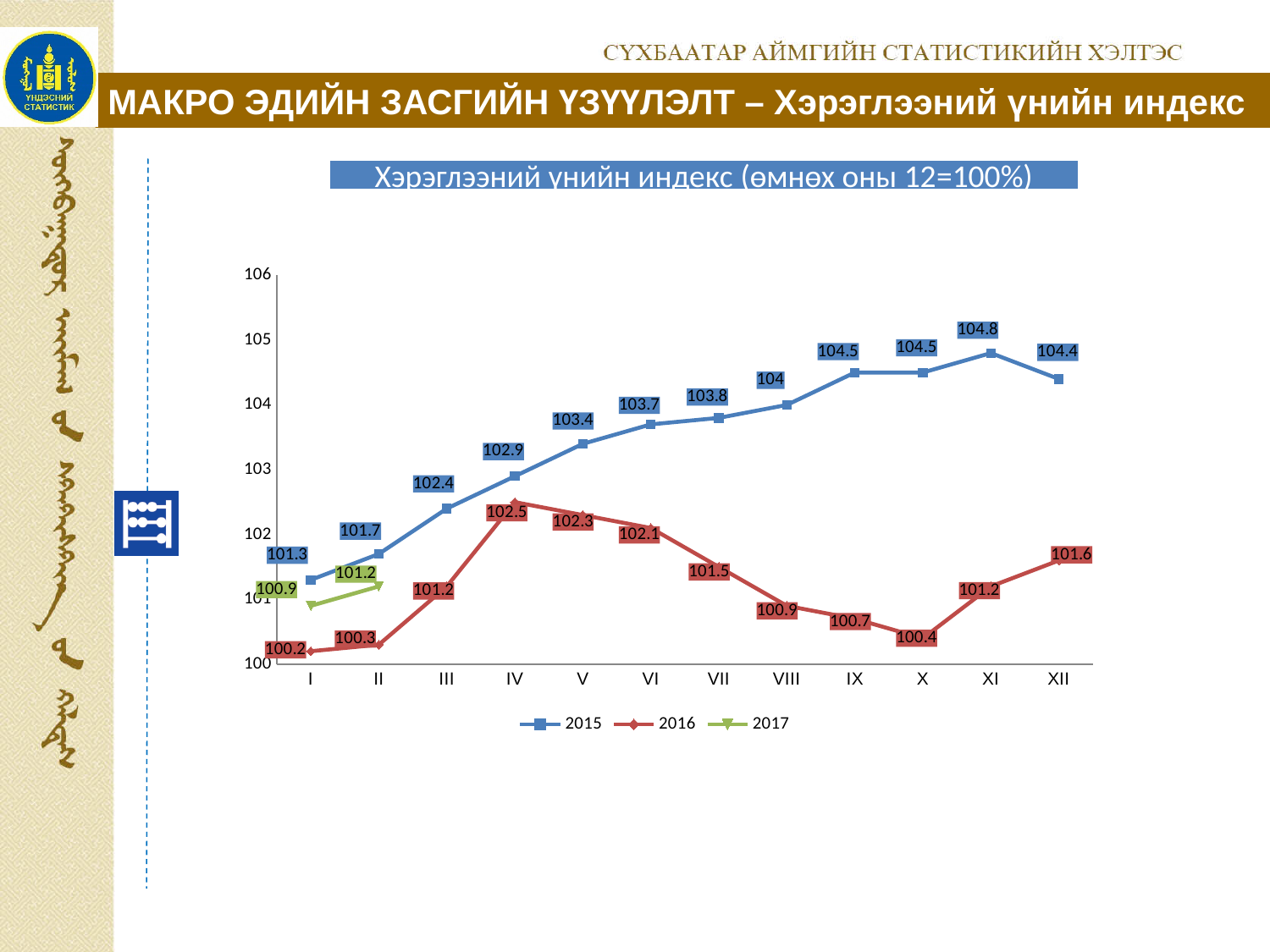
Does the 2015 series generally rise or fall from month I to month XI? rise How many series does the legend list? 3 What is the value for 2016 in month IV? 102.5 In which month does the 2016 series have its lowest value? I How many months are shown on the x axis? 12 What is the value for 2017 in month II? 101.2 What is the title of the chart? Хэрэглээний үнийн индекс (өмнөх оны 12=100%) What is the difference between the 2015 and 2016 values in month XII? 2.8 What type of chart is shown on the slide? line chart In which month does the 2016 series reach its highest value? IV Which is larger in month I: the 2015 value or the 2017 value? 2015 What is the value for 2015 in month XI? 104.8